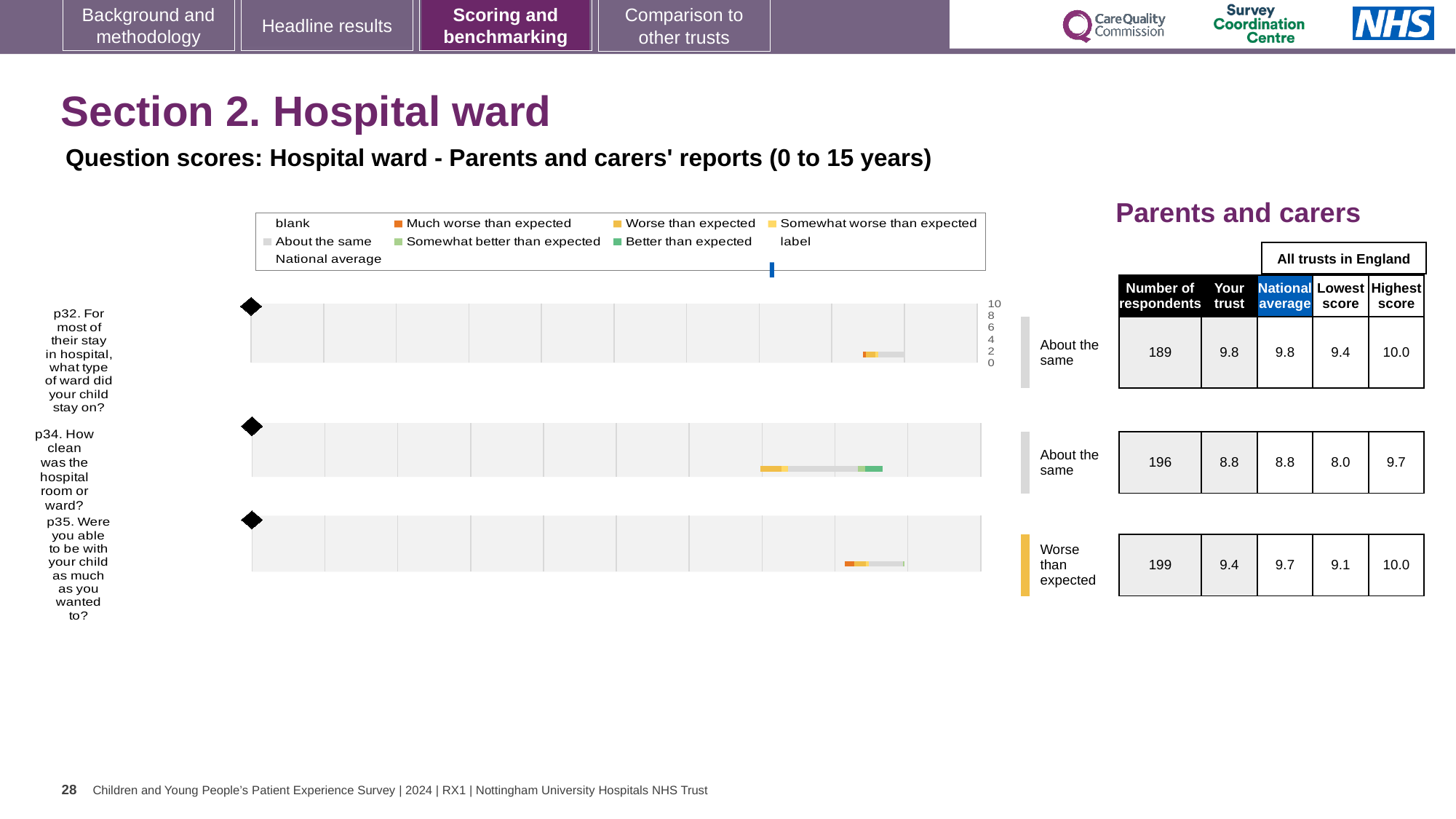
What is the lowest score among all trusts in England for p34? 8.0 For p35, how much higher is the national average than the 'Your trust' score? 0.3 For p34, what is the difference between the highest and lowest scores across all trusts in England? 1.7 What is the national average score for p35 (Were you able to be with your child as much as you wanted to?)? 9.7 Which question has the highest 'Your trust' score on this slide? p32 What is the highest score among all trusts in England for p35? 10.0 How many respondents answered p32 (what type of ward did your child stay on)? 189 What kind of chart is used to show the question scores on this slide? bar chart How many survey questions are plotted on this slide? 3 Which question has the fewest respondents? p32 What is the 'Your trust' score for p34 (How clean was the hospital room or ward?)? 8.8 What benchmark category is shown for p35 (Were you able to be with your child as much as you wanted to?)? Worse than expected